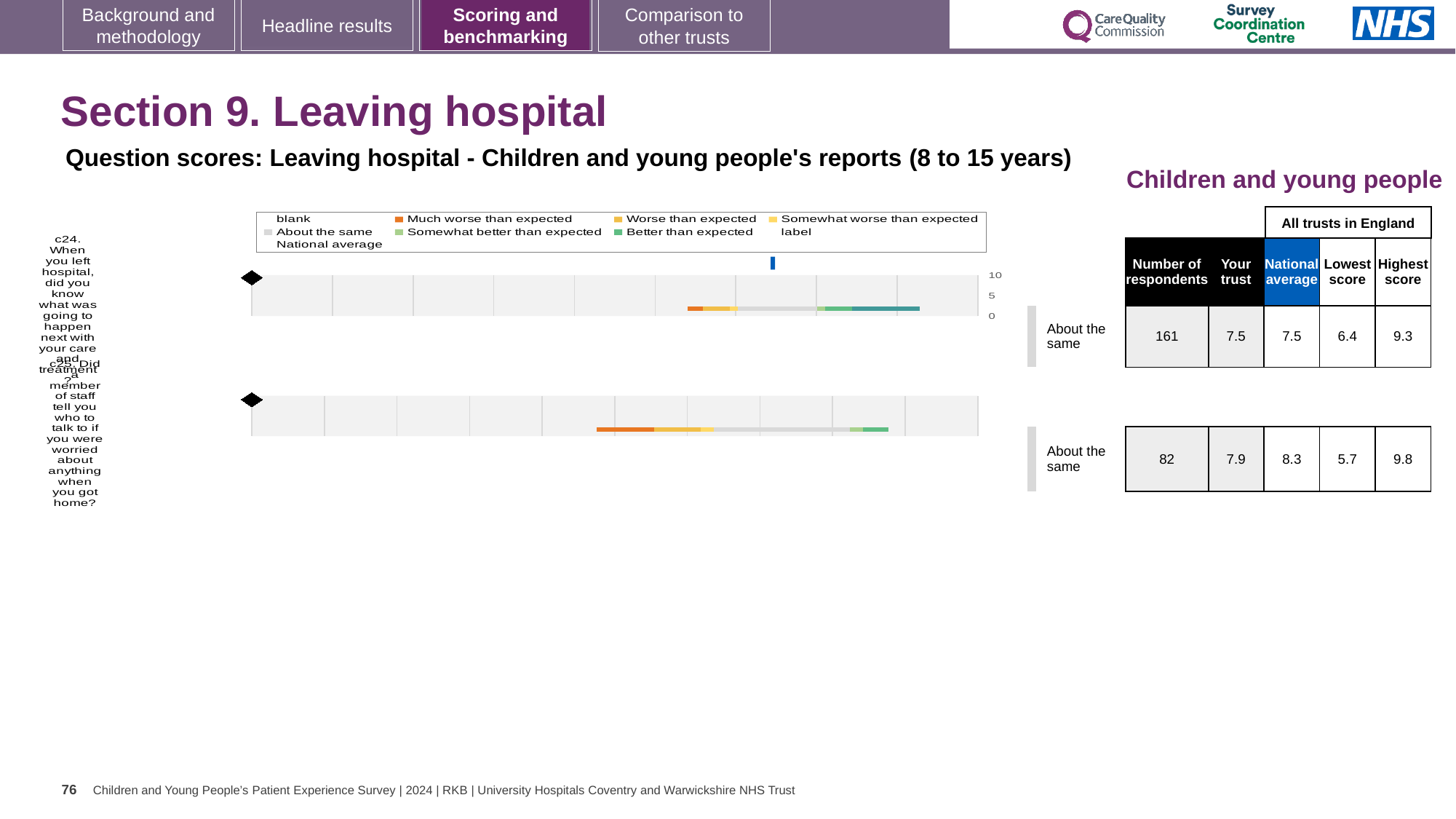
What benchmark category is shown for question c24 (did you know what was going to happen next with your care and treatment)? About the same What kind of chart is used to show the question scores for Leaving hospital? bar chart What is the national average score for question c24? 7.5 What is the highest score across all trusts in England for question c25? 9.8 How many more respondents answered question c24 than question c25? 79 How many survey questions are plotted in the Leaving hospital chart? 2 What is the lowest score across all trusts in England for question c24? 6.4 What is the difference between the highest score and the lowest score for question c25? 4.1 In the chart legend, what colour represents 'Much worse than expected'? orange Which question has the higher 'Your trust' score, c24 or c25? c25 How many respondents answered question c24 according to the table beside the chart? 161 What is the 'Your trust' score for question c25 (did a member of staff tell you who to talk to if you were worried)? 7.9